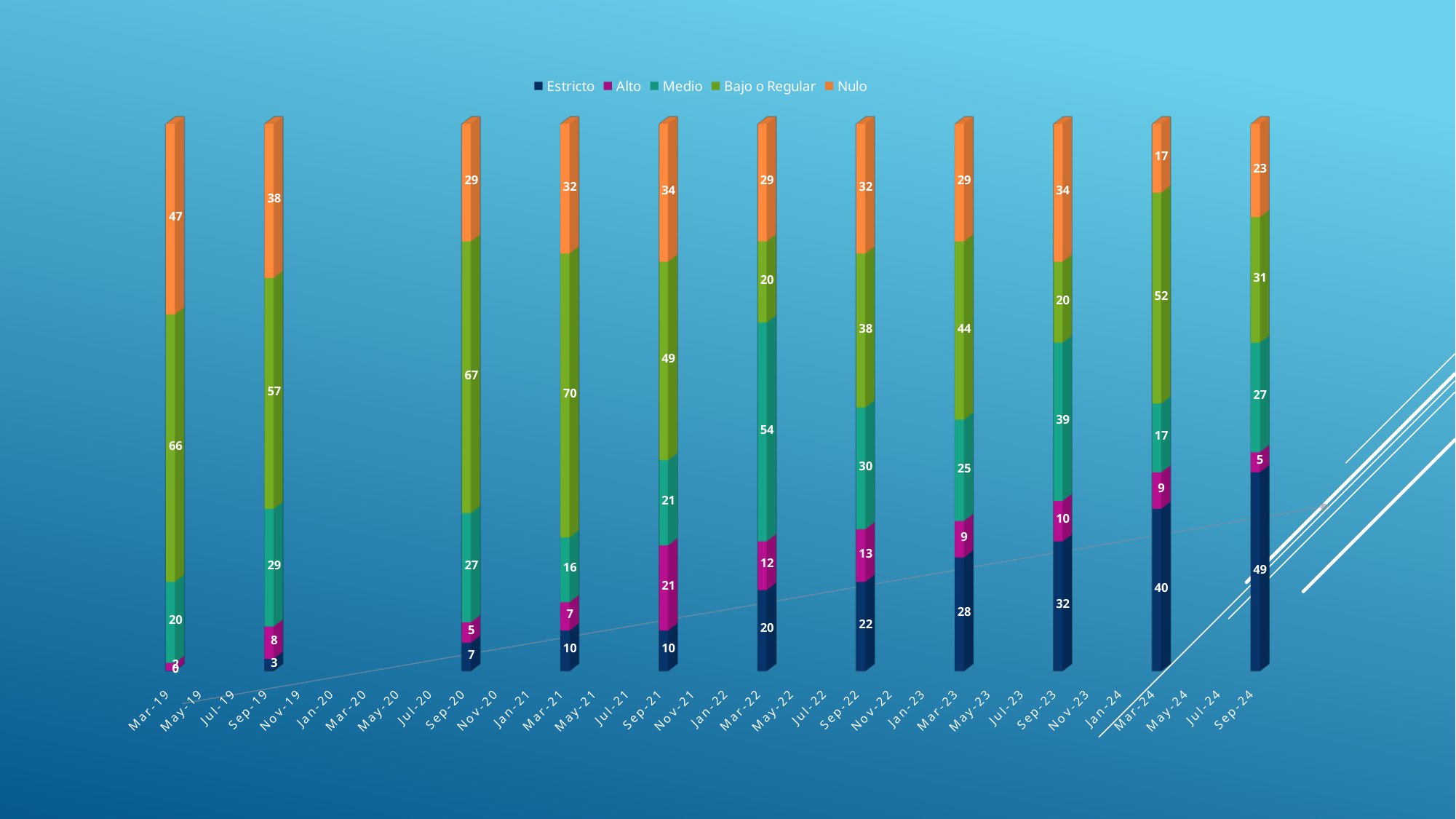
What kind of chart is shown on the slide? Stacked bar chart What is the value of Medio for Mar-22? 54 Which period has the lowest Nulo value? Mar-24 What is the value of Bajo o Regular for Mar-21? 70 What is the difference between the Estricto values for Mar-24 and Sep-23? 8 What is the value of Estricto for Sep-24? 49 How many series does the legend list? 5 Which is larger, the Alto value for Sep-21 or the Alto value for Sep-22? Sep-21 How many periods have bars plotted in the chart? 11 What is the value of Nulo for Sep-19? 38 Which period has the highest Estricto value? Sep-24 What is the total of the stacked bar for Sep-24? 135